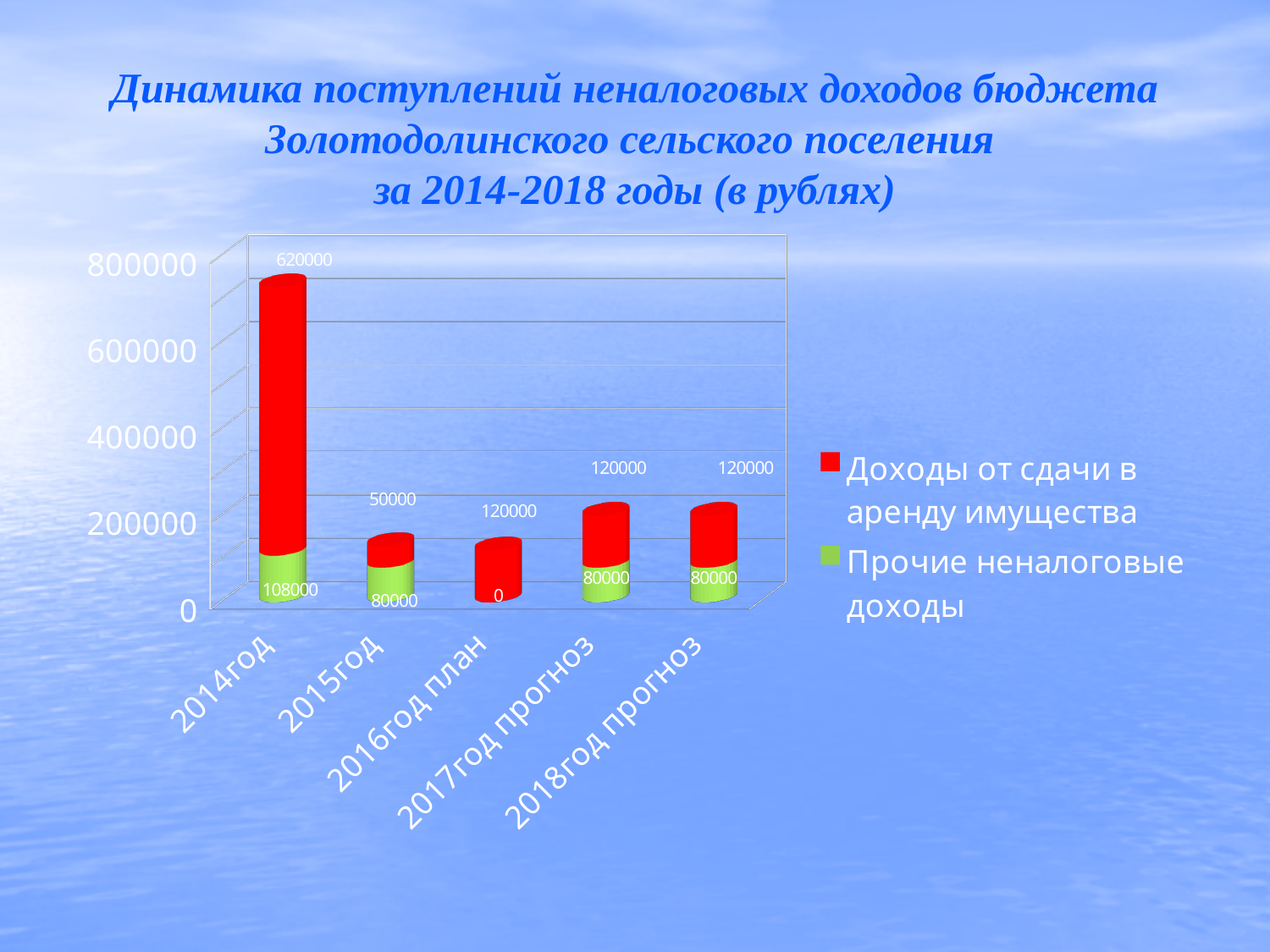
Which is larger: "Прочие неналоговые доходы" for 2014год or for 2017год прогноз? 2014год What is the value of "Прочие неналоговые доходы" for 2016год план? 0 How many series does the legend list? 2 How many categories are shown on the x axis? 5 What is the value of "Доходы от сдачи в аренду имущества" for 2014год? 620000 What is the difference between the "Доходы от сдачи в аренду имущества" values for 2014год and 2015год? 570000 What kind of chart is shown on the slide? Stacked bar chart What is the value of "Прочие неналоговые доходы" for 2015год? 80000 Which category has the lowest value for "Прочие неналоговые доходы"? 2016год план Which category has the highest value for "Доходы от сдачи в аренду имущества"? 2014год What is the total of the stacked bar for 2017год прогноз? 200000 What is the value of "Доходы от сдачи в аренду имущества" for 2018год прогноз? 120000